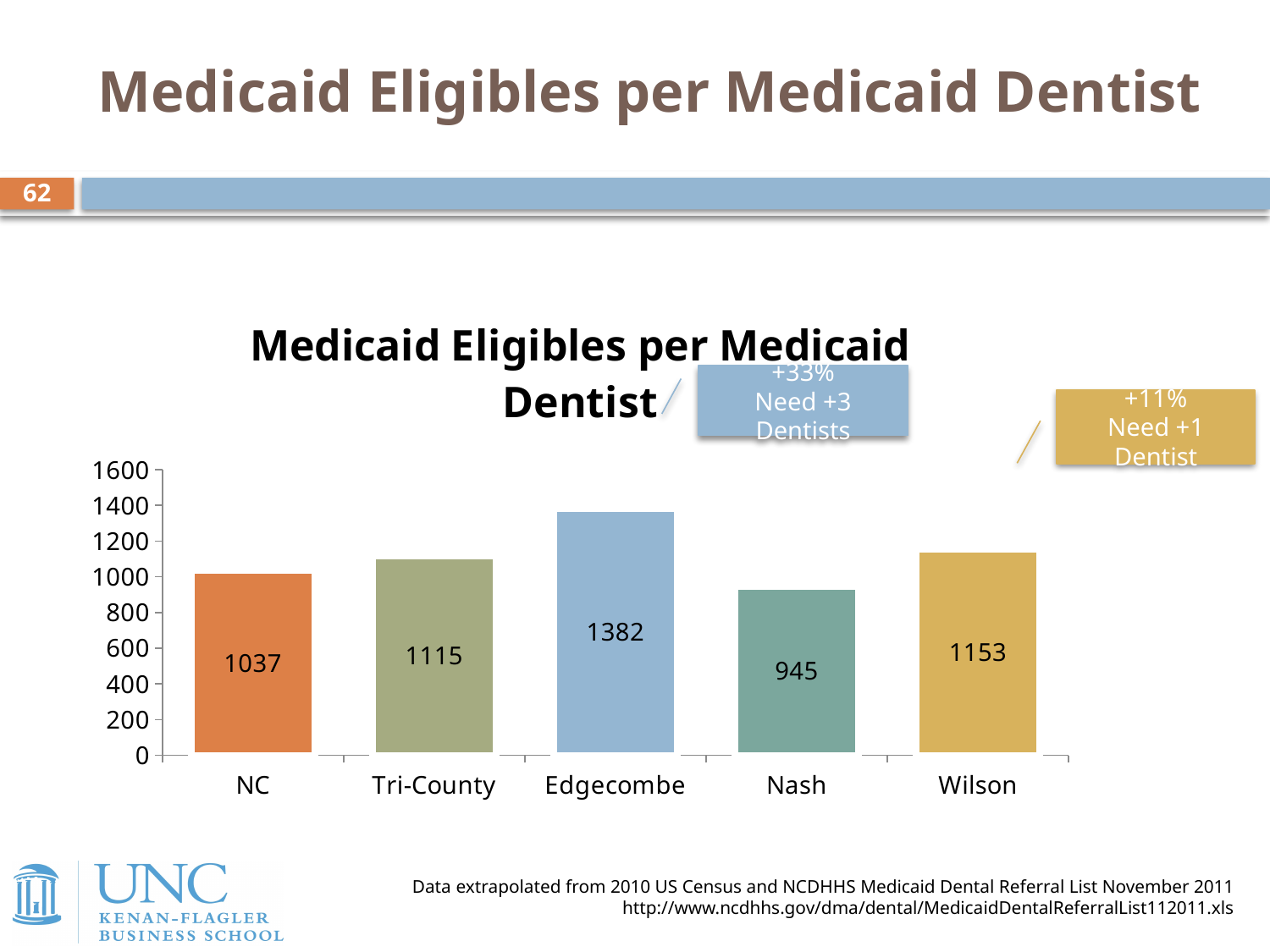
Which is larger, the value for Wilson or the value for Tri-County? Wilson Which category has the highest value? Edgecombe What is the value for Nash? 945 What is the difference between the values for Tri-County and NC? 78 What is the difference between the values for Edgecombe and Nash? 437 What is the title of the chart? Medicaid Eligibles per Medicaid Dentist What is the value for Edgecombe? 1382 How many categories are shown on the x axis? 5 What is the value for Wilson? 1153 What is the value for NC? 1037 Which category has the lowest value? Nash What kind of chart is shown on the slide? Bar chart